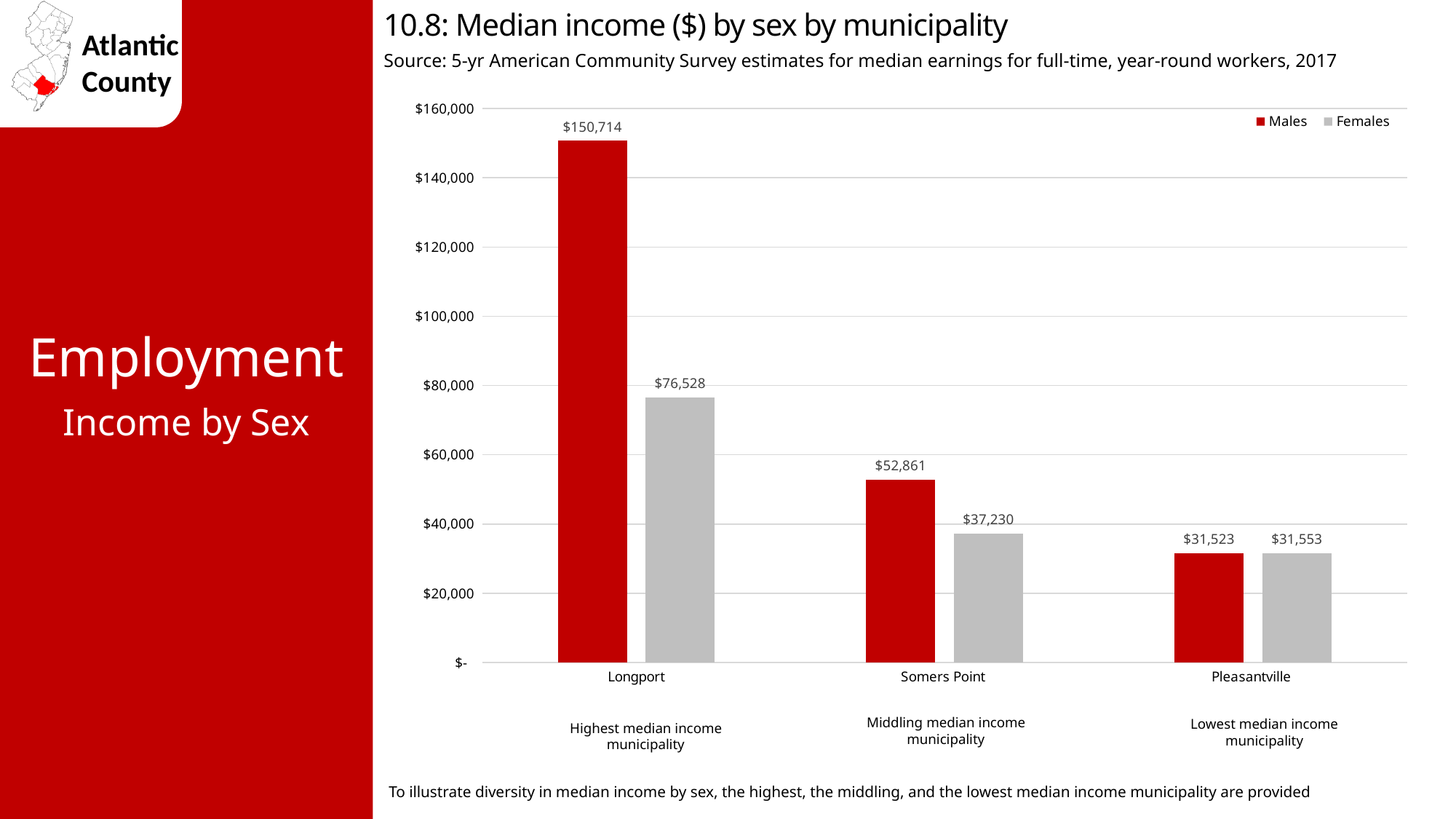
What is the median income for females in Somers Point? $37,230 Which municipality has the lowest median income for females? Pleasantville What is the difference between male and female median income in Longport? $74,186 What kind of chart is shown on the slide? Bar chart What is the difference between male and female median income in Somers Point? $15,631 How many municipalities are shown on the chart? 3 Which municipality has the highest median income for males? Longport What is the median income for males in Longport? $150,714 Is the median income for females in Longport greater or less than $80,000? less What is the median income for females in Pleasantville? $31,553 How many series does the legend list? 2 Which is larger in Pleasantville, the male or the female median income? Females